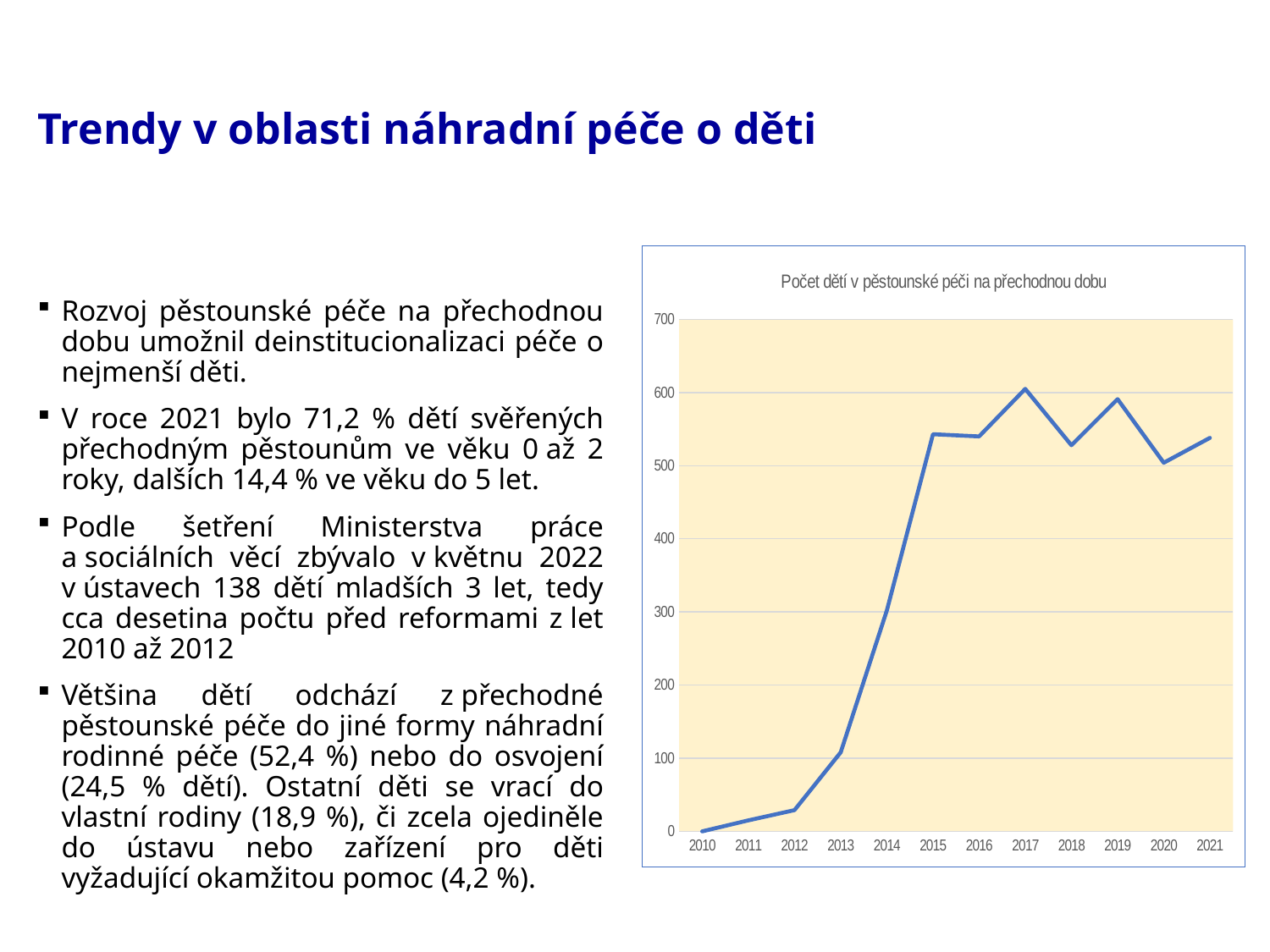
What is the title of the chart? Počet dětí v pěstounské péči na přechodnou dobu Which year has the highest value in the chart? 2017 Is the value for 2014 greater or less than 400? less What kind of chart is shown on the slide? line chart Is the value for 2018 greater or less than 600? less Which year has the lowest value in the chart? 2010 Which year has the larger value, 2014 or 2015? 2015 Which year has the larger value, 2017 or 2020? 2017 Do the values rise or fall from 2010 to 2015? rise How many years are plotted on the x axis of the chart? 12 Is the value for 2012 greater or less than 100? less